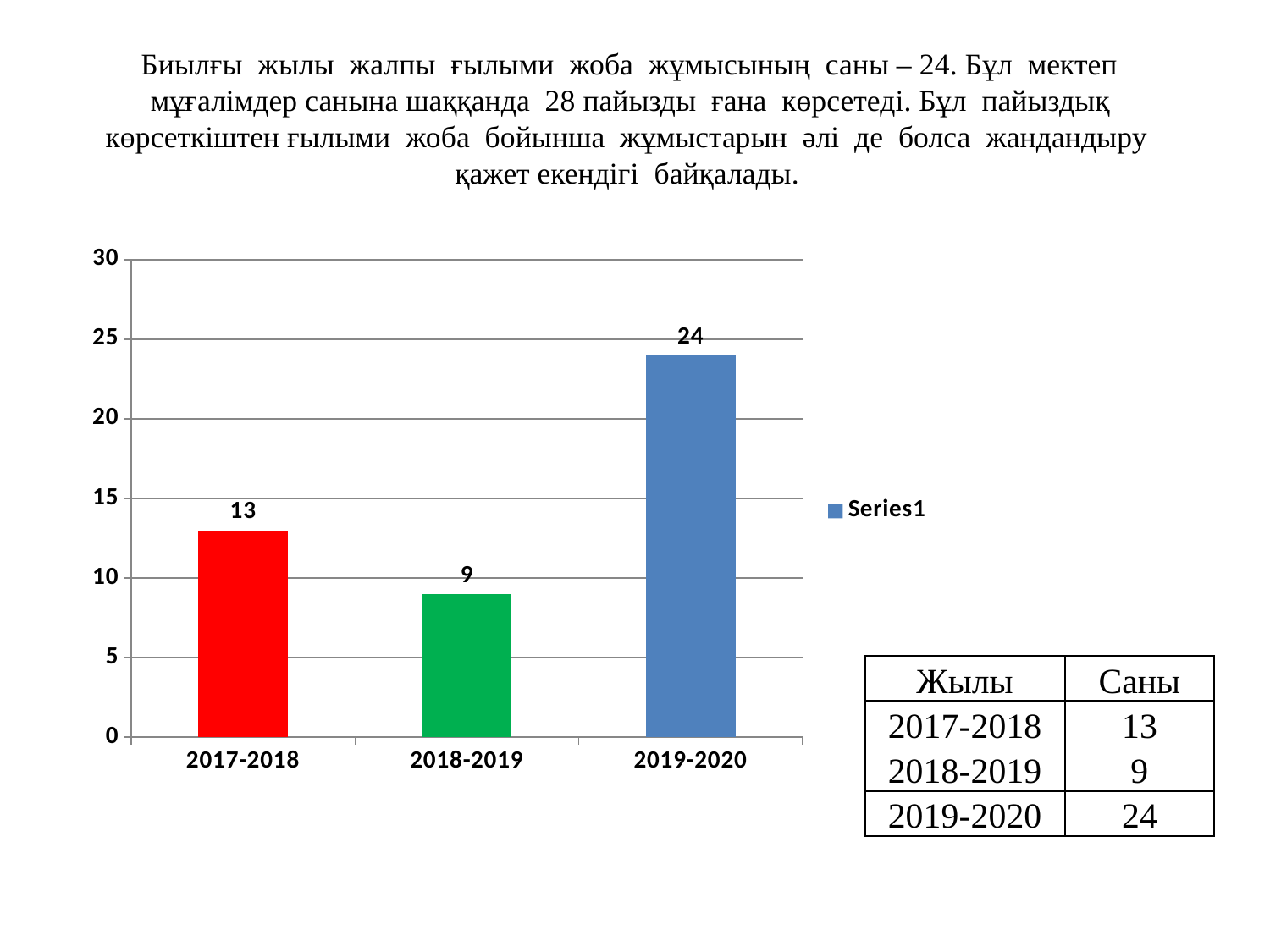
Which is larger, the value for 2017-2018 or the value for 2018-2019? 2017-2018 How many series does the legend list? 1 Is the value for 2019-2020 greater or less than 20? greater Which category has the lowest value? 2018-2019 What is the difference between the values for 2019-2020 and 2017-2018? 11 How many categories are shown on the x axis? 3 What is the value for 2018-2019? 9 Which category has the highest value? 2019-2020 What is the value for 2017-2018? 13 What kind of chart is shown on the slide? bar chart What is the difference between the values for 2017-2018 and 2018-2019? 4 What is the value for 2019-2020? 24